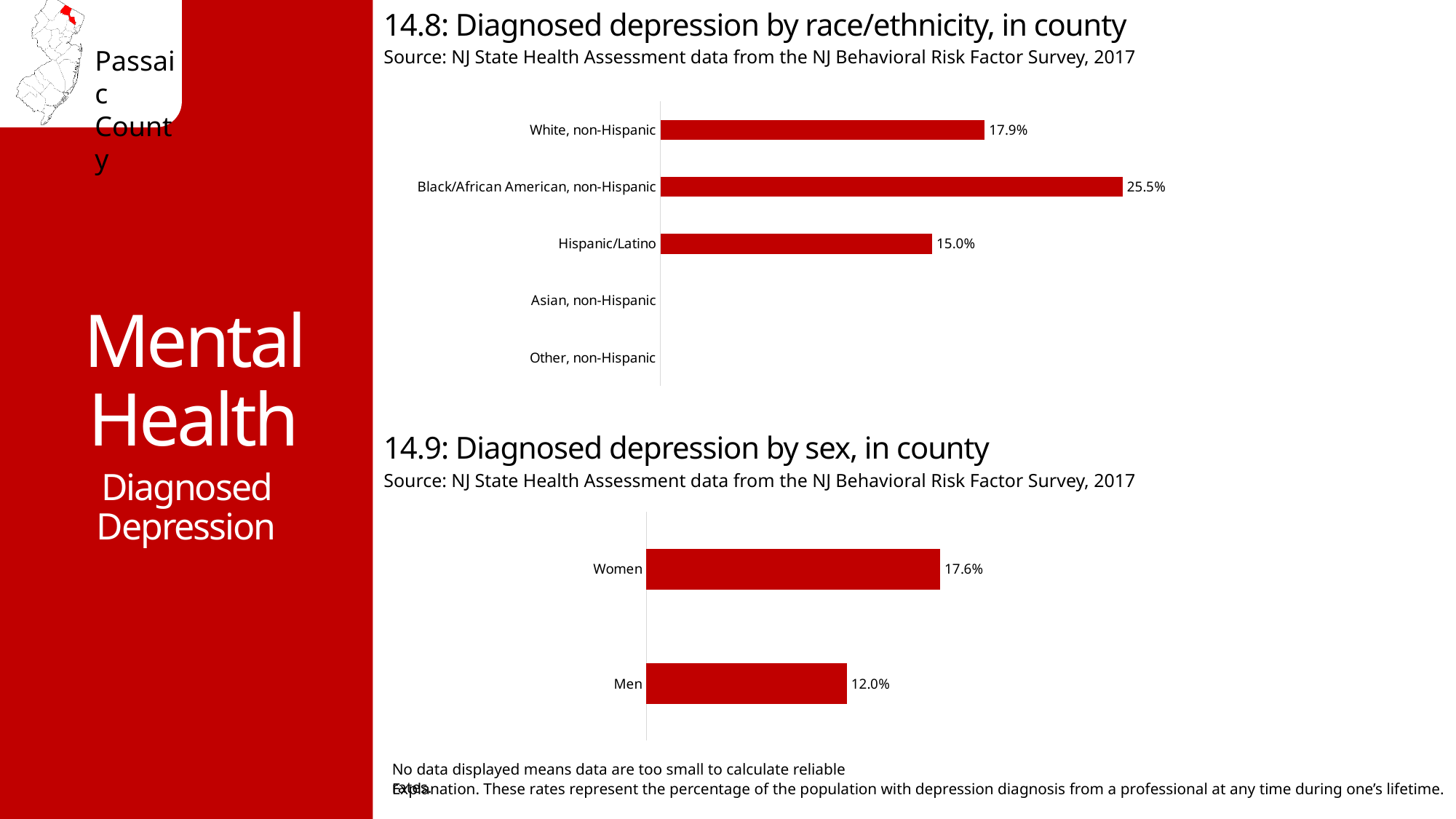
What kind of chart is '14.9: Diagnosed depression by sex, in county'? Bar chart In the chart '14.8: Diagnosed depression by race/ethnicity, in county', which category has the highest value? Black/African American, non-Hispanic In the chart '14.8: Diagnosed depression by race/ethnicity, in county', which categories have no bar displayed? Asian, non-Hispanic and Other, non-Hispanic In the chart '14.9: Diagnosed depression by sex, in county', what is the value for Men? 12.0% In the chart '14.8: Diagnosed depression by race/ethnicity, in county', what is the difference between the values for Black/African American, non-Hispanic and White, non-Hispanic? 7.6% In the chart '14.8: Diagnosed depression by race/ethnicity, in county', what is the value for Hispanic/Latino? 15.0% In the chart '14.9: Diagnosed depression by sex, in county', what is the difference between the values for Women and Men? 5.6% In the chart '14.9: Diagnosed depression by sex, in county', which category has the lowest value? Men In the chart '14.8: Diagnosed depression by race/ethnicity, in county', what is the value for Black/African American, non-Hispanic? 25.5% In the chart '14.8: Diagnosed depression by race/ethnicity, in county', which is larger, the value for White, non-Hispanic or Hispanic/Latino? White, non-Hispanic In the chart '14.9: Diagnosed depression by sex, in county', what is the value for Women? 17.6% In the chart '14.8: Diagnosed depression by race/ethnicity, in county', how many categories are listed on the axis? 5